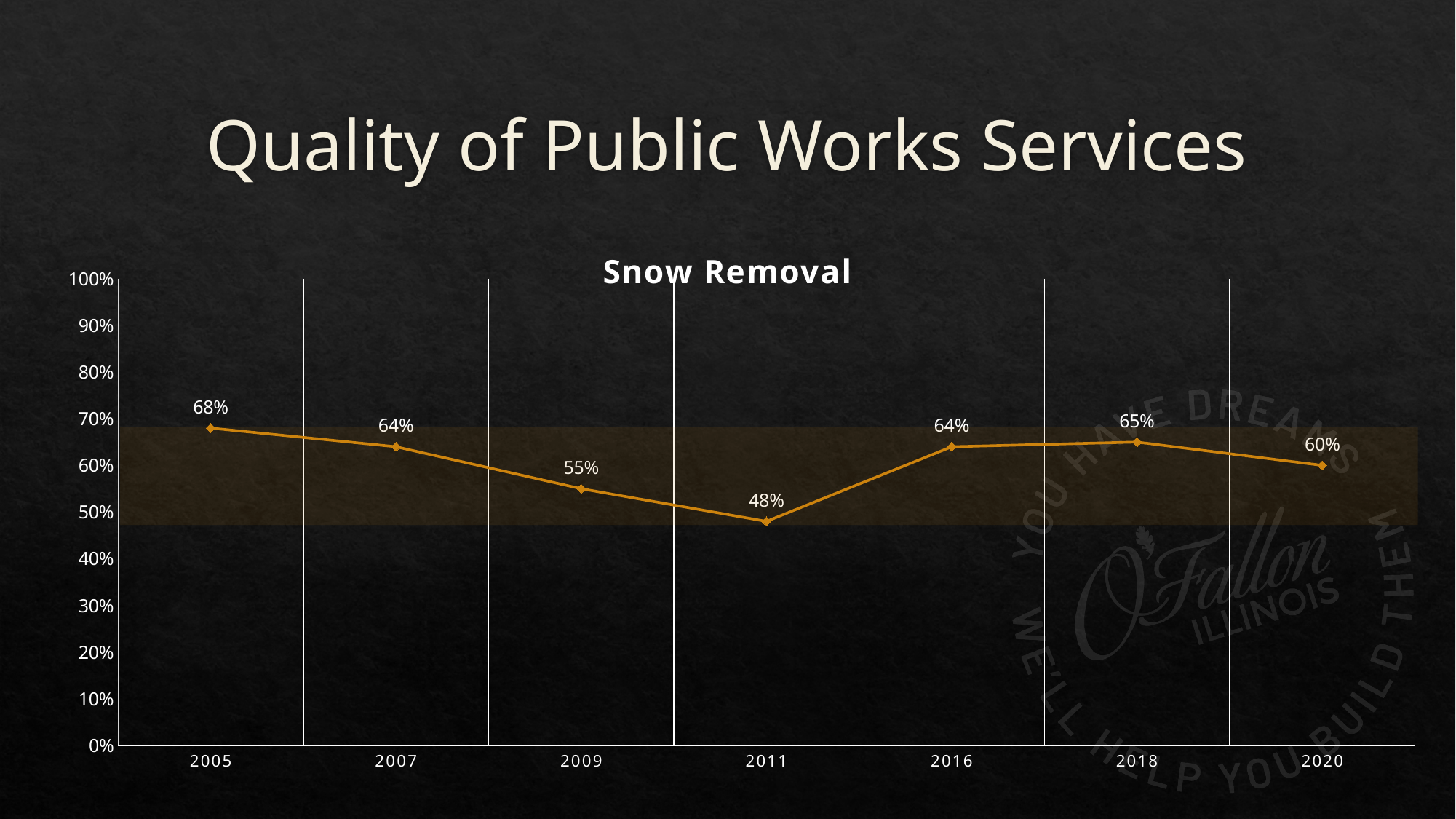
Is the Snow Removal value for 2011 greater or less than 50%? less Which year has the lowest Snow Removal value? 2011 Which is larger, the Snow Removal value for 2009 or for 2016? 2016 What kind of chart is shown on the slide? line chart What is the Snow Removal value for 2020? 60% What is the Snow Removal value for 2005? 68% How many years are plotted on the Snow Removal chart? 7 Do the Snow Removal values rise or fall from 2005 to 2011? fall What is the Snow Removal value for 2011? 48% What is the difference between the Snow Removal values for 2005 and 2011? 20% Which year has the highest Snow Removal value? 2005 What is the difference between the Snow Removal values for 2018 and 2020? 5%